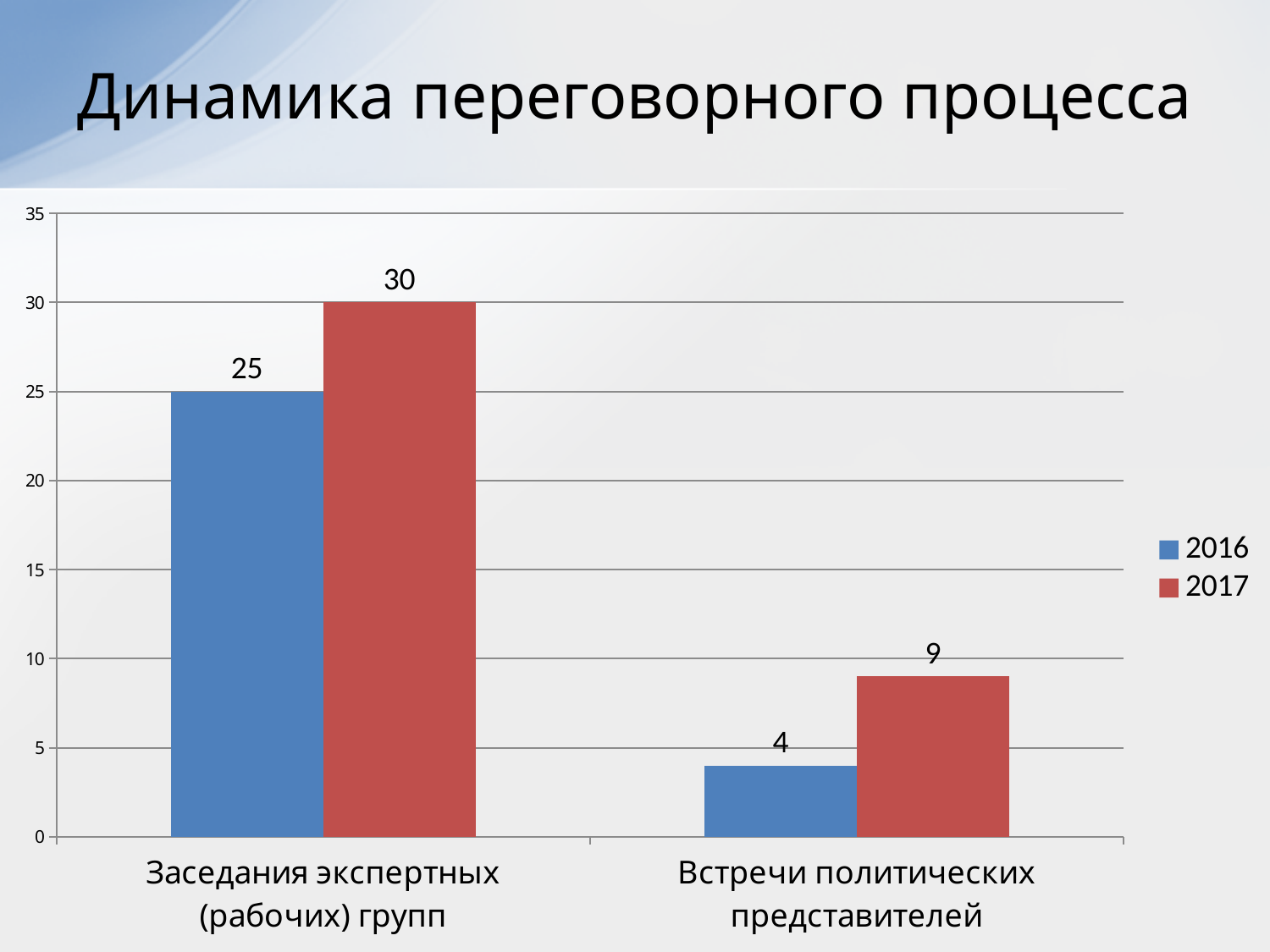
What is the value for 2017 in the category "Заседания экспертных (рабочих) групп"? 30 How many categories are shown on the x axis? 2 What is the value for 2016 in the category "Встречи политических представителей"? 4 Which category has the highest value for 2017? Заседания экспертных (рабочих) групп How many series does the legend list? 2 Which is larger for "Встречи политических представителей": the 2016 value or the 2017 value? 2017 What is the difference between the 2017 and 2016 values for "Встречи политических представителей"? 5 What is the value for 2017 in the category "Встречи политических представителей"? 9 What is the value for 2016 in the category "Заседания экспертных (рабочих) групп"? 25 What kind of chart is shown on the slide? Bar chart Which category has the lowest value for 2016? Встречи политических представителей What is the difference between the 2017 and 2016 values for "Заседания экспертных (рабочих) групп"? 5